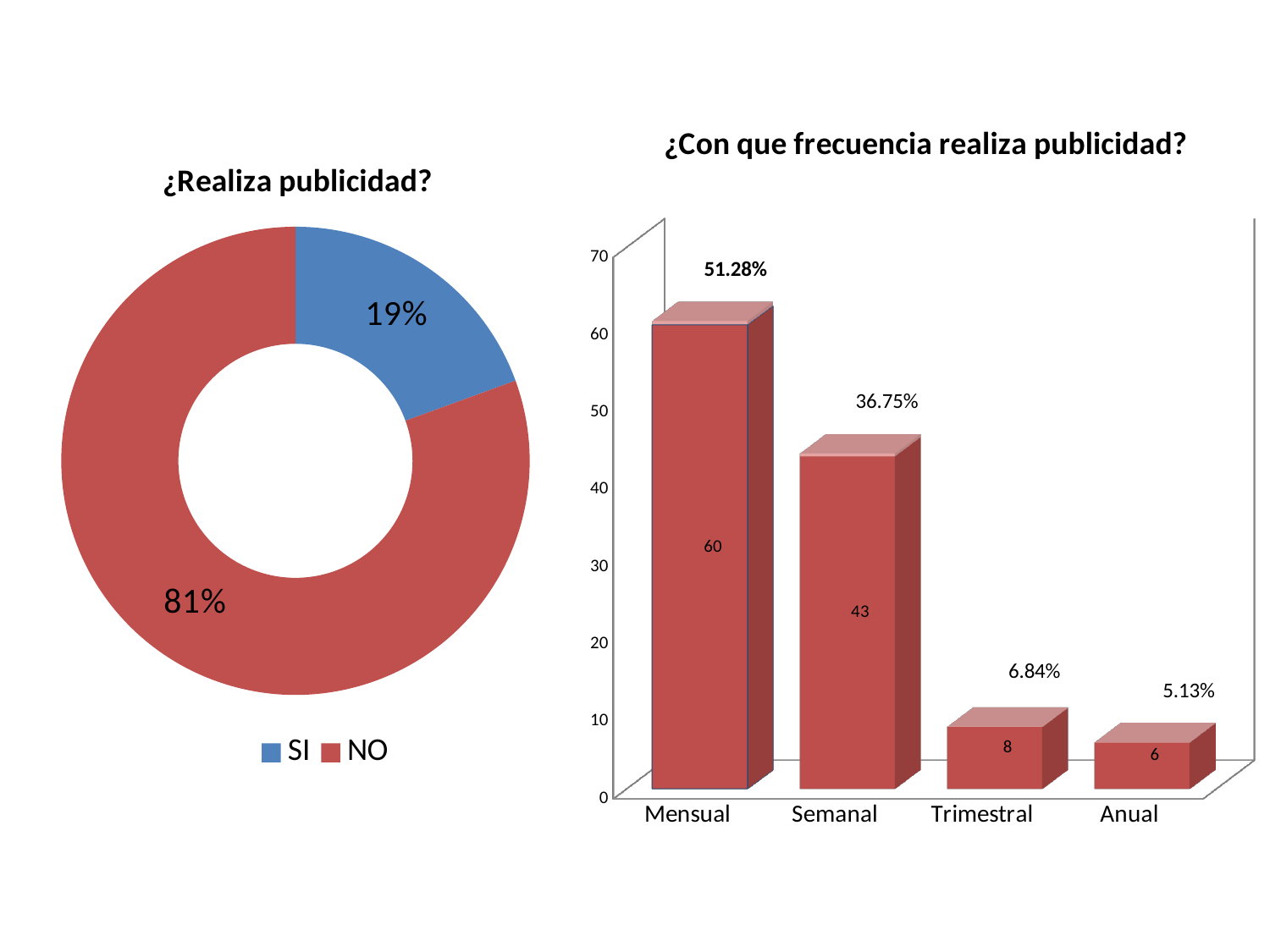
In the '¿Con que frecuencia realiza publicidad?' chart, what is the value for Mensual? 60 In the '¿Con que frecuencia realiza publicidad?' chart, what is the value for Anual? 6 How many entries does the legend of the '¿Realiza publicidad?' chart list? 2 In the '¿Con que frecuencia realiza publicidad?' chart, what is the difference between the Mensual and Semanal values? 17 In the '¿Con que frecuencia realiza publicidad?' chart, what percentage is shown above the Semanal bar? 36.75% In the '¿Realiza publicidad?' chart, what percentage is shown for SI? 19% In the '¿Con que frecuencia realiza publicidad?' chart, which category has the highest value? Mensual What kind of chart is '¿Realiza publicidad?'? Doughnut (pie) chart In the '¿Realiza publicidad?' chart, what percentage is shown for NO? 81% How many categories are shown in the '¿Con que frecuencia realiza publicidad?' chart? 4 What kind of chart is '¿Con que frecuencia realiza publicidad?'? Bar chart In the '¿Con que frecuencia realiza publicidad?' chart, which category has the lowest value? Anual